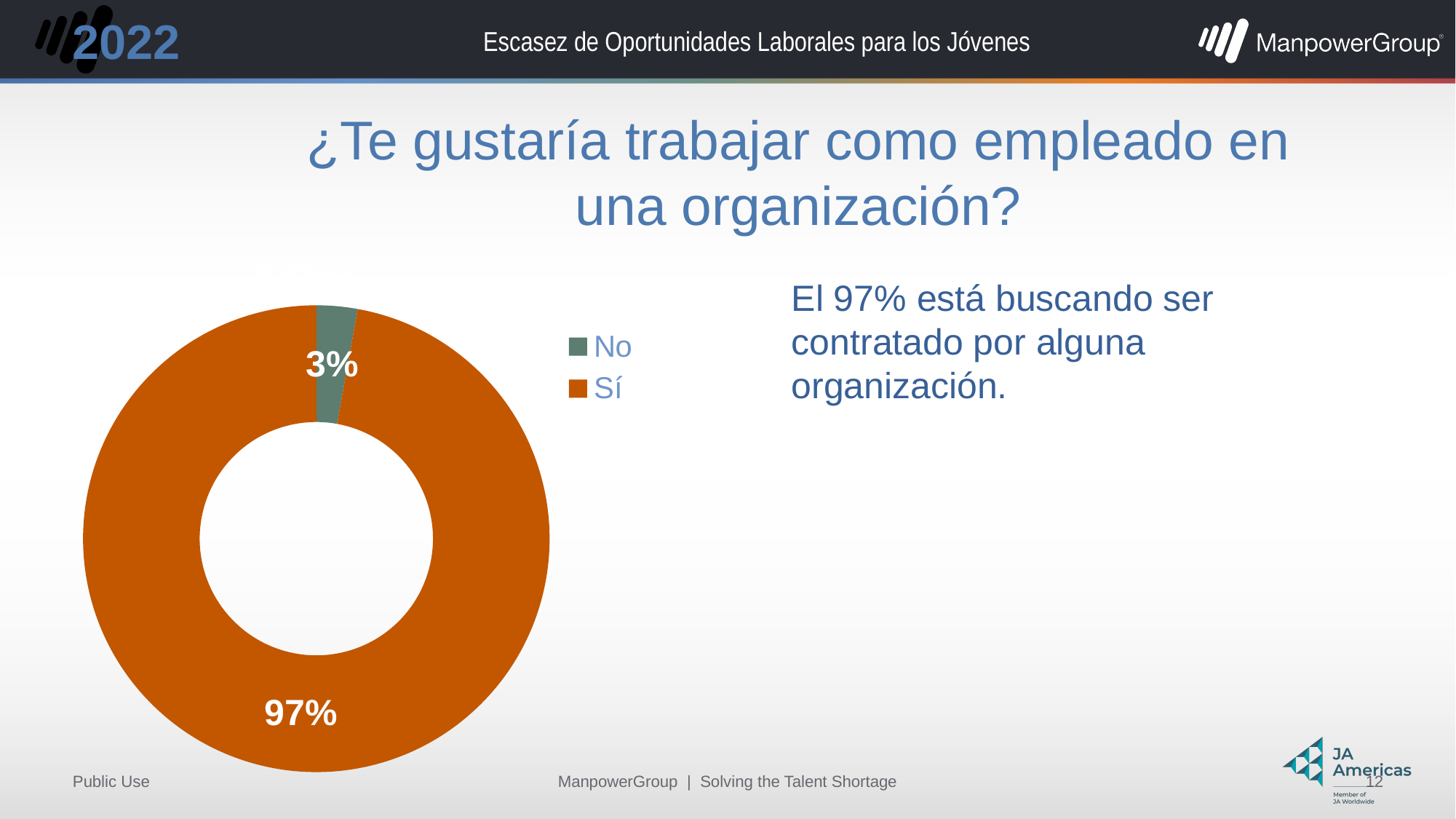
How many entries does the legend list? 2 Which category has the smallest share of the chart? No What share of the chart does the "No" slice represent? 3% What percentage of the doughnut chart is labelled "No"? 3% What question does the chart's title ask? ¿Te gustaría trabajar como empleado en una organización? What is the difference in percentage points between the "Sí" and "No" slices? 94 How many categories does the chart show? 2 What colour is the "Sí" slice in the chart? Orange Which slice is larger, "Sí" or "No"? Sí Which category has the largest share of the chart? Sí What kind of chart is shown on the slide? Doughnut (pie) chart What percentage of the doughnut chart is labelled "Sí"? 97%